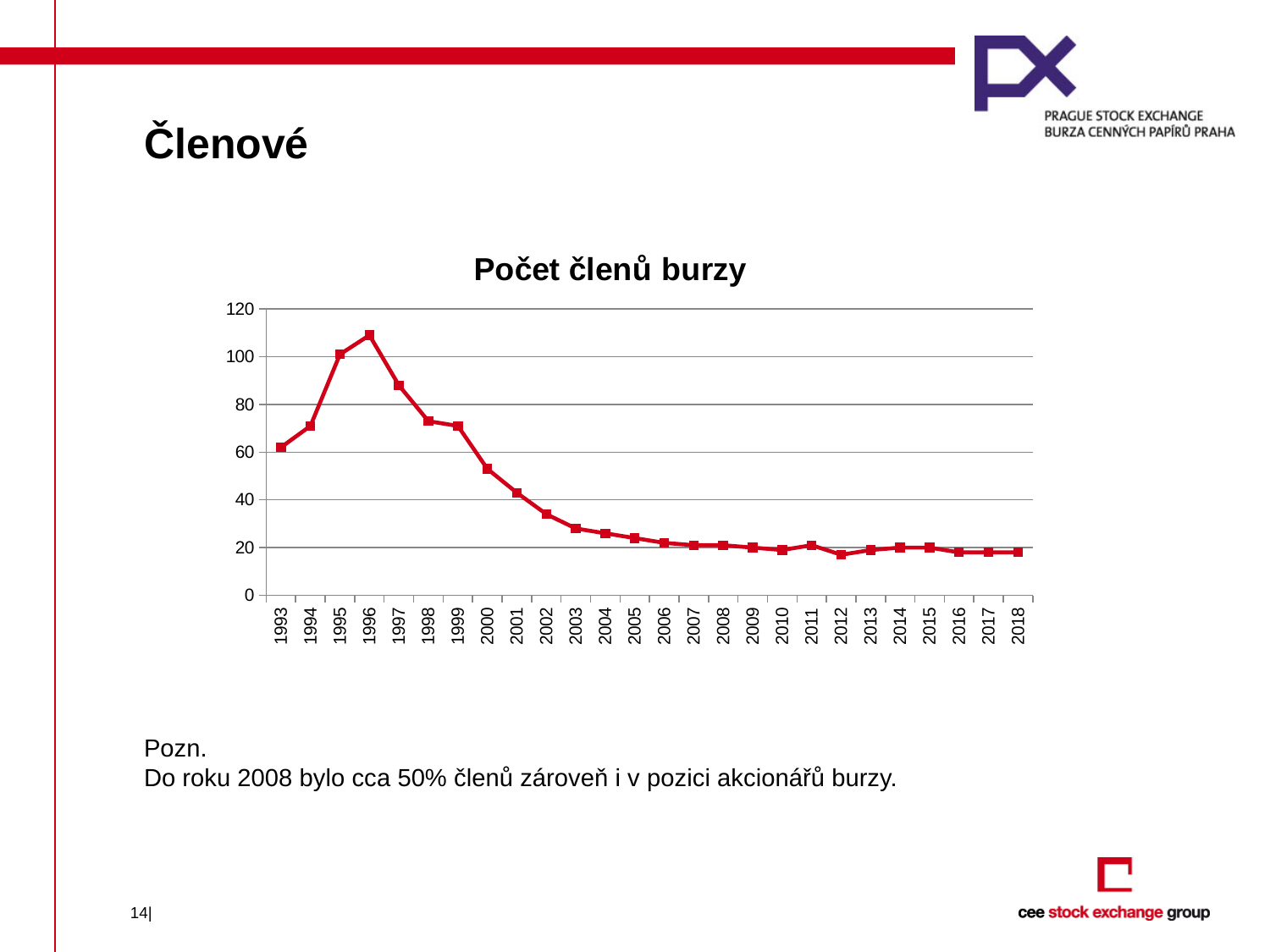
What kind of chart is shown on the slide? line chart Is the value for 2002 greater or less than 40? less Is the value for 2018 greater or less than 40? less In which year is the number of exchange members highest? 1996 Do the values rise or fall between 1996 and 2010? fall How many years are plotted on the x axis of the chart? 26 Which year has a higher value, 1995 or 1993? 1995 What is the title of the chart? Počet členů burzy Is the value for 2000 greater or less than 60? less Which year has a higher value, 1999 or 2005? 1999